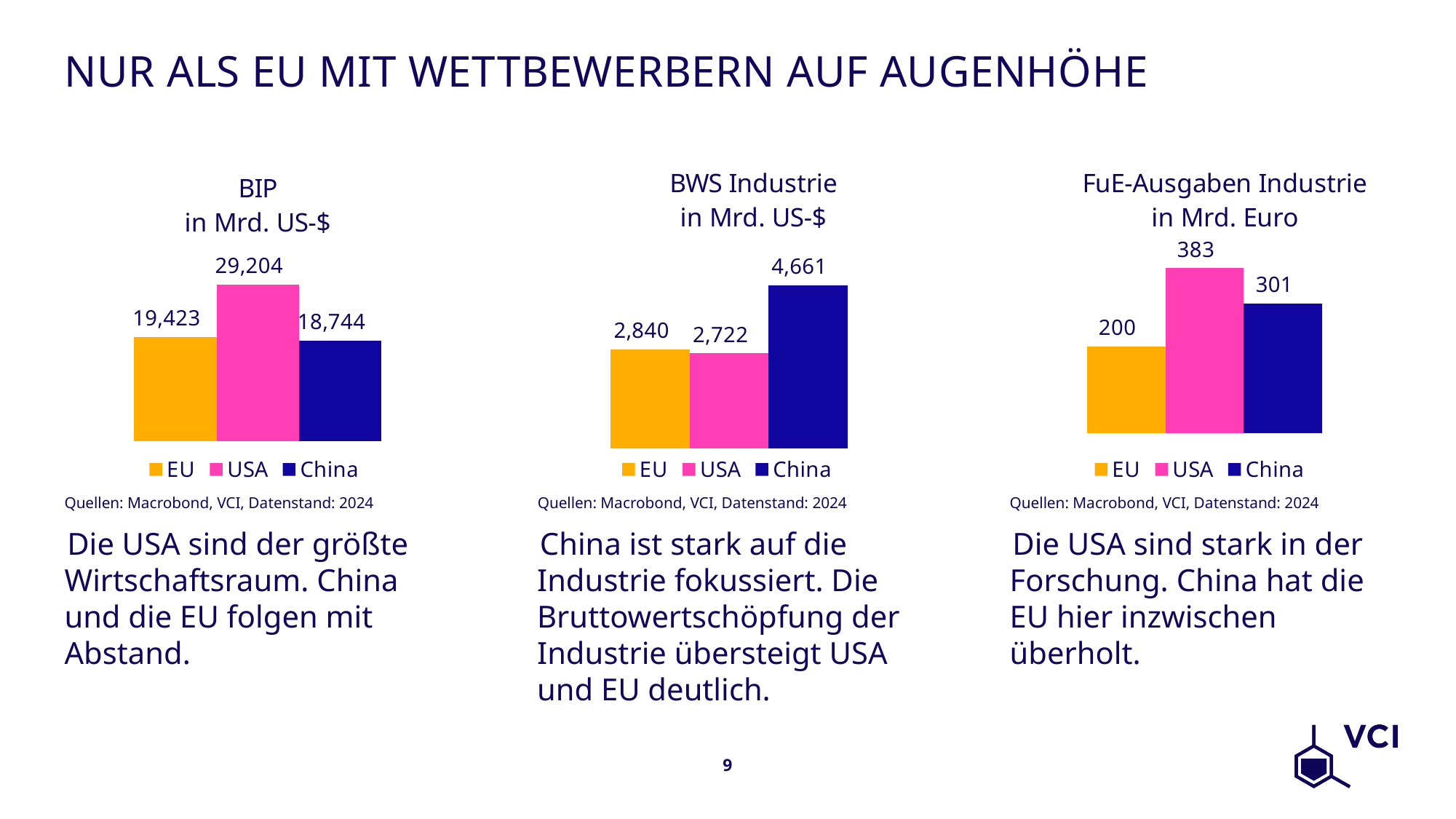
In the 'BIP in Mrd. US-$' chart, what is the difference between the EU and China values? 679 In the 'FuE-Ausgaben Industrie in Mrd. Euro' chart, what is the value for the EU? 200 How many bars are shown in the 'BIP in Mrd. US-$' chart? 3 In the 'FuE-Ausgaben Industrie in Mrd. Euro' chart, what is the difference between the USA and China values? 82 In the 'BWS Industrie in Mrd. US-$' chart, which is larger, the value for the EU or the value for the USA? EU In the 'FuE-Ausgaben Industrie in Mrd. Euro' chart, which region has the highest value? USA In the 'BIP in Mrd. US-$' chart, what is the value for the USA? 29,204 In the 'BIP in Mrd. US-$' chart, which region has the lowest value? China In the 'BWS Industrie in Mrd. US-$' chart, what is the value for China? 4,661 In the 'FuE-Ausgaben Industrie in Mrd. Euro' chart, what colour is the bar for the USA? Pink What kind of chart is the 'BWS Industrie in Mrd. US-$' chart? Bar chart In the 'BWS Industrie in Mrd. US-$' chart, what is the difference between the China and EU values? 1,821